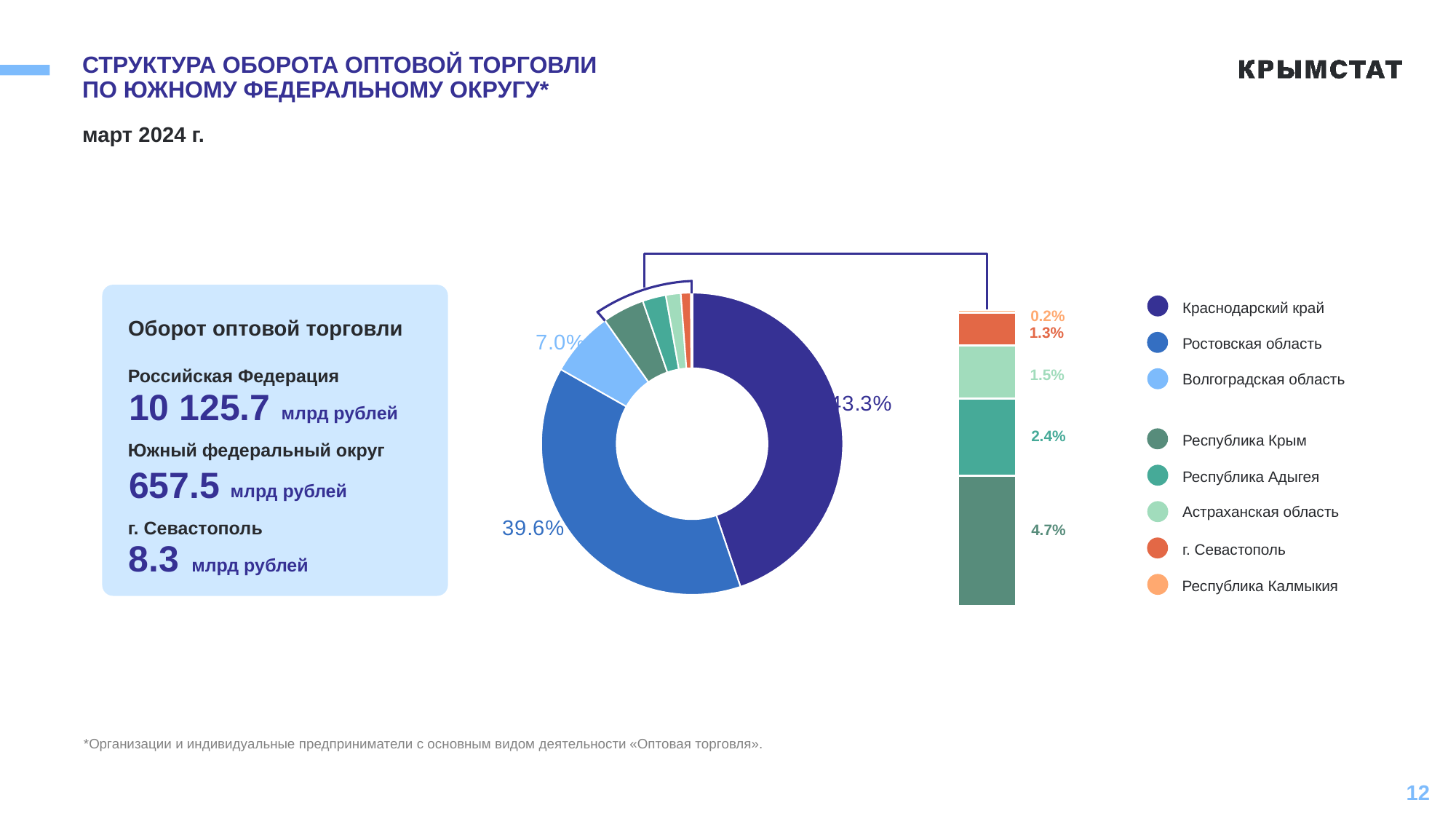
Чья доля больше: Республики Адыгея или Астраханской области? Республика Адыгея Какой регион имеет наименьшую долю в обороте оптовой торговли ЮФО? Республика Калмыкия Какой регион имеет наибольшую долю в обороте оптовой торговли ЮФО? Краснодарский край Какого типа диаграмма показана на слайде? Кольцевая (круговая) диаграмма Какова суммарная доля Республики Крым и Республики Адыгея? 7.1% Какая доля приходится на Волгоградскую область? 7.0% Какая доля приходится на Республику Крым? 4.7% Какая доля оборота оптовой торговли приходится на Краснодарский край? 43.3% Какая доля приходится на Ростовскую область? 39.6% Сколько регионов перечислено в легенде диаграммы? 8 На сколько процентных пунктов доля Краснодарского края больше доли Ростовской области? 3.7 Какая доля приходится на г. Севастополь? 1.3%